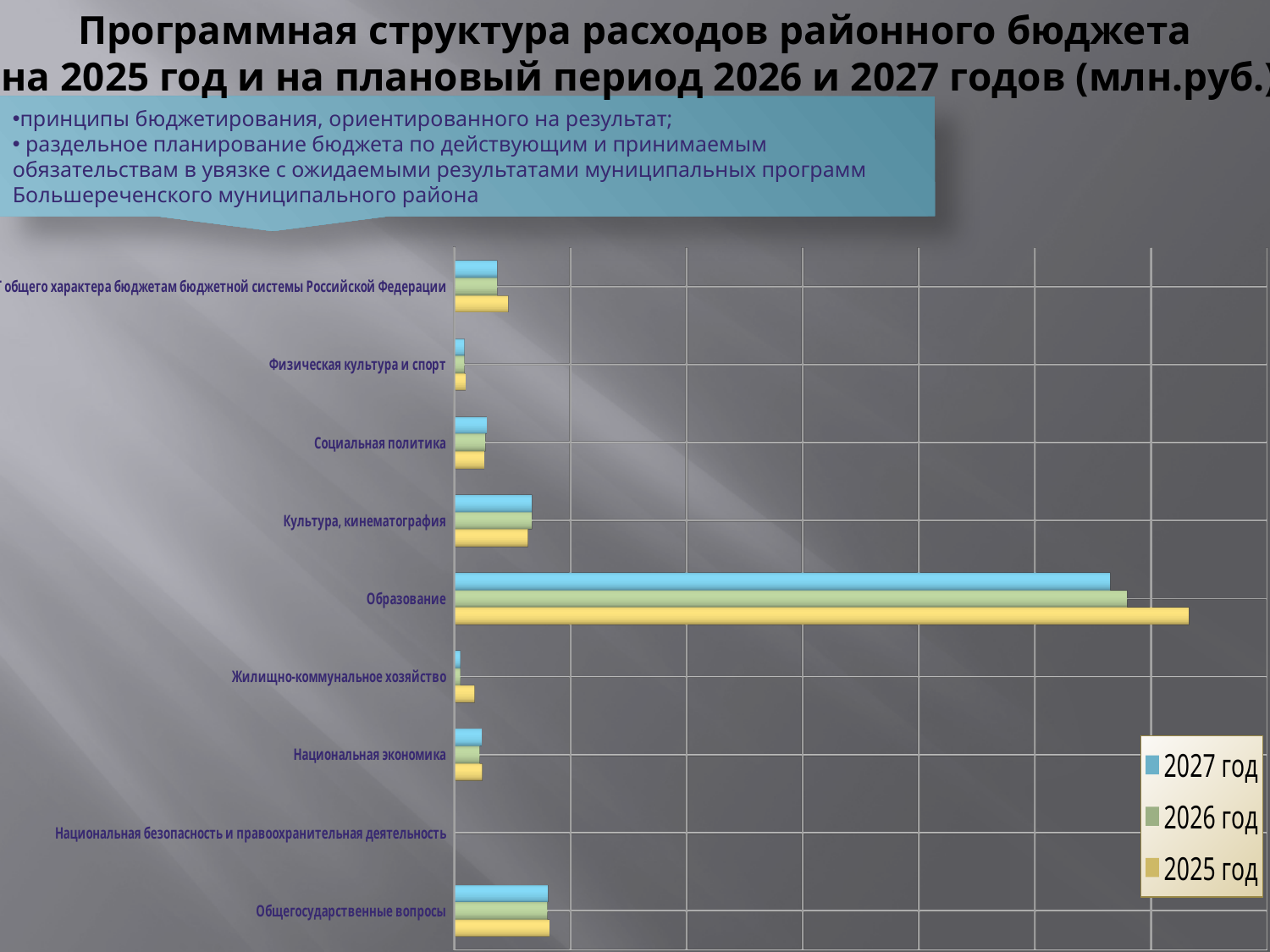
How many series does the chart legend list? 3 What colour represents the 2025 год series in the chart? yellow What are the entries listed in the chart legend? 2027 год, 2026 год, 2025 год Which category shows no visible bars in the chart? Национальная безопасность и правоохранительная деятельность Which is larger: the value for Образование or for Общегосударственные вопросы? Образование What kind of chart is shown on the slide? bar chart For Жилищно-коммунальное хозяйство, which year has the larger value: 2025 год or 2027 год? 2025 год For Образование, which year has the larger value: 2025 год or 2027 год? 2025 год Which category has the longest bars in the chart? Образование How many categories are shown on the vertical axis of the chart? 9